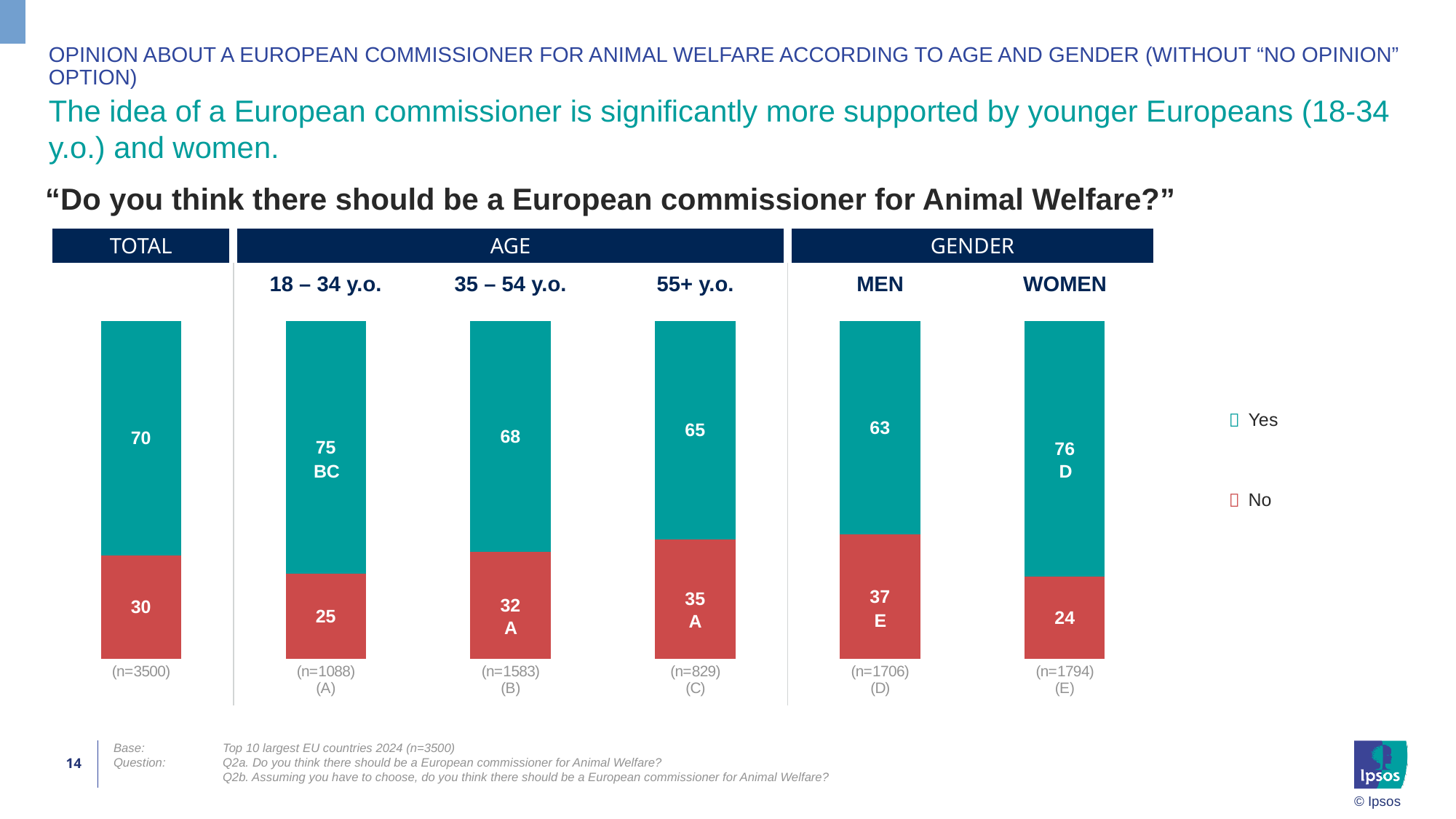
Which group has the lowest "No" value? WOMEN What is the total of the stacked bar for the 35 – 54 y.o. group? 100 Across the three age groups from 18 – 34 y.o. to 55+ y.o., do the "Yes" values rise or fall? Fall What is the "No" value for the 55+ y.o. group? 35 How many groups (bars) are shown in the chart? 6 How many series does the legend list? 2 Which group has the highest "Yes" value? WOMEN What percentage of the TOTAL group answered "Yes"? 70 What is the "Yes" value for MEN? 63 Which has a larger "No" value, the 18 – 34 y.o. group or the 35 – 54 y.o. group? 35 – 54 y.o. What kind of chart is shown on the slide? Stacked bar chart What is the difference between the "Yes" values for WOMEN and MEN? 13